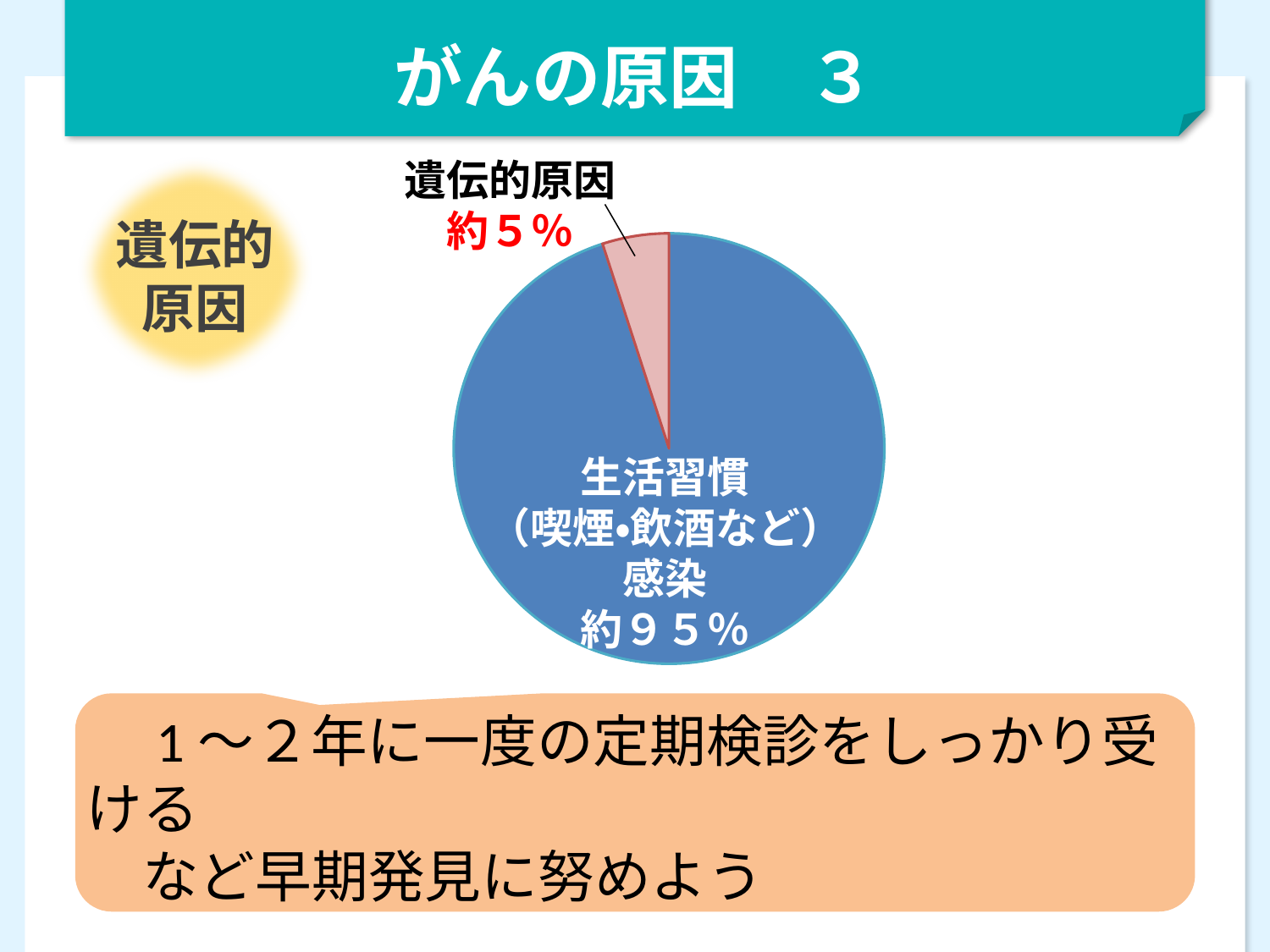
How many slices does the pie chart have? 2 What colour is the 遺伝的原因 slice of the pie chart? pink What is the difference in percentage points between the 生活習慣（喫煙・飲酒など）感染 slice and the 遺伝的原因 slice? 90 What kind of chart is shown on the slide? pie chart What share of the pie is labelled 生活習慣（喫煙・飲酒など）感染? 約９５％ Which slice of the pie chart is the largest? 生活習慣（喫煙・飲酒など）感染 Which slice of the pie chart is the smallest? 遺伝的原因 What is the title shown at the top of the slide? がんの原因 ３ Which is larger, the share for 遺伝的原因 or the share for 生活習慣（喫煙・飲酒など）感染? 生活習慣（喫煙・飲酒など）感染 What share of the pie is labelled 遺伝的原因? 約５％